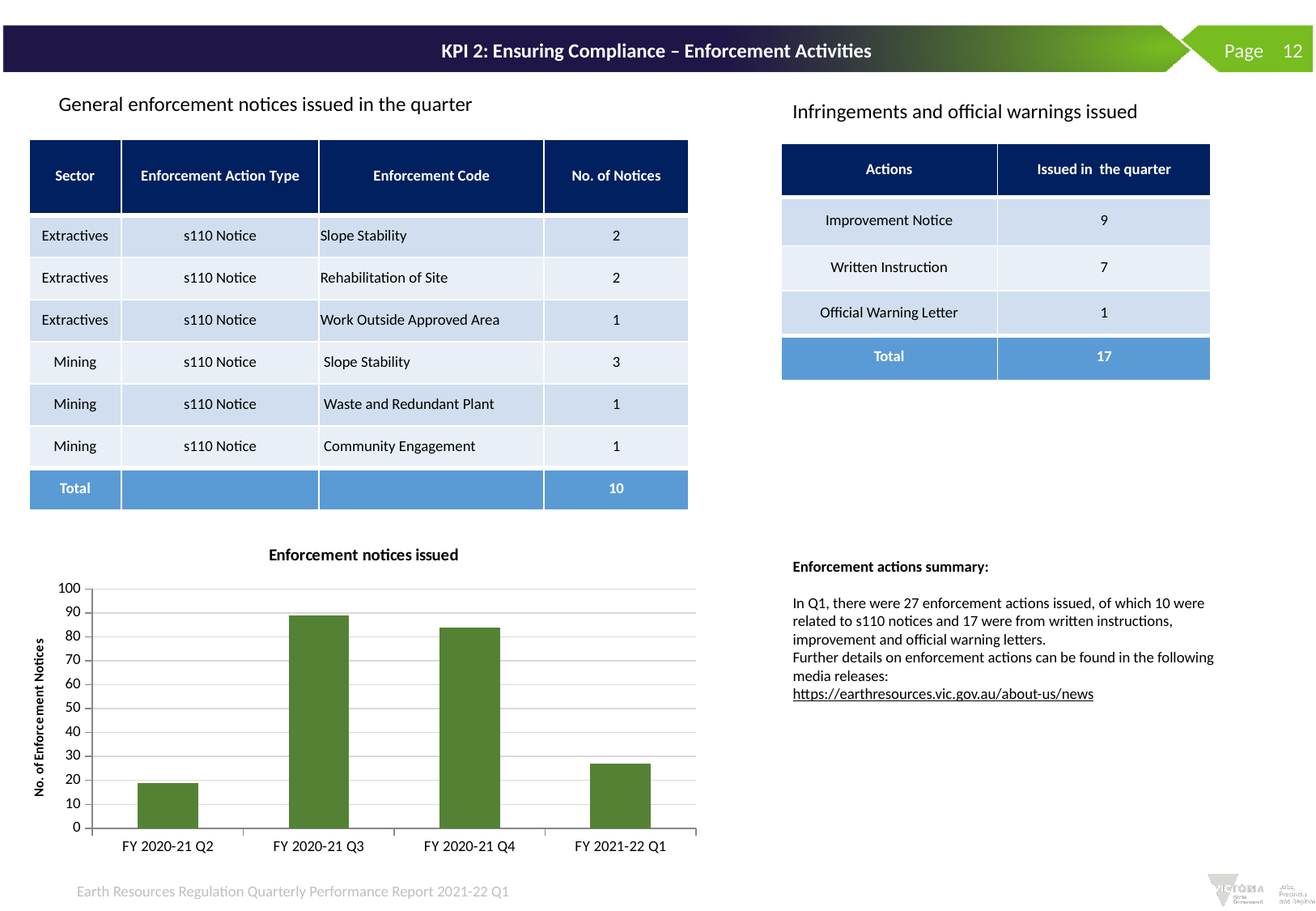
In the 'Enforcement notices issued' chart, is the value for FY 2020-21 Q3 greater or less than 80? greater What kind of chart is the 'Enforcement notices issued' chart? bar chart In the 'Enforcement notices issued' chart, is the value for FY 2020-21 Q2 greater or less than 30? less In the 'Enforcement notices issued' chart, is the value for FY 2021-22 Q1 greater or less than 40? less What is the label on the vertical axis of the 'Enforcement notices issued' chart? No. of Enforcement Notices In the 'Enforcement notices issued' chart, which quarter has the lowest number of enforcement notices? FY 2020-21 Q2 In the 'Enforcement notices issued' chart, which quarter has the highest number of enforcement notices? FY 2020-21 Q3 In the 'Enforcement notices issued' chart, which quarter has more enforcement notices, FY 2020-21 Q4 or FY 2021-22 Q1? FY 2020-21 Q4 In the 'Enforcement notices issued' chart, which quarter has more enforcement notices, FY 2020-21 Q2 or FY 2021-22 Q1? FY 2021-22 Q1 In the 'Enforcement notices issued' chart, does the number of enforcement notices rise or fall from FY 2020-21 Q4 to FY 2021-22 Q1? fall How many quarters are shown on the x axis of the 'Enforcement notices issued' chart? 4